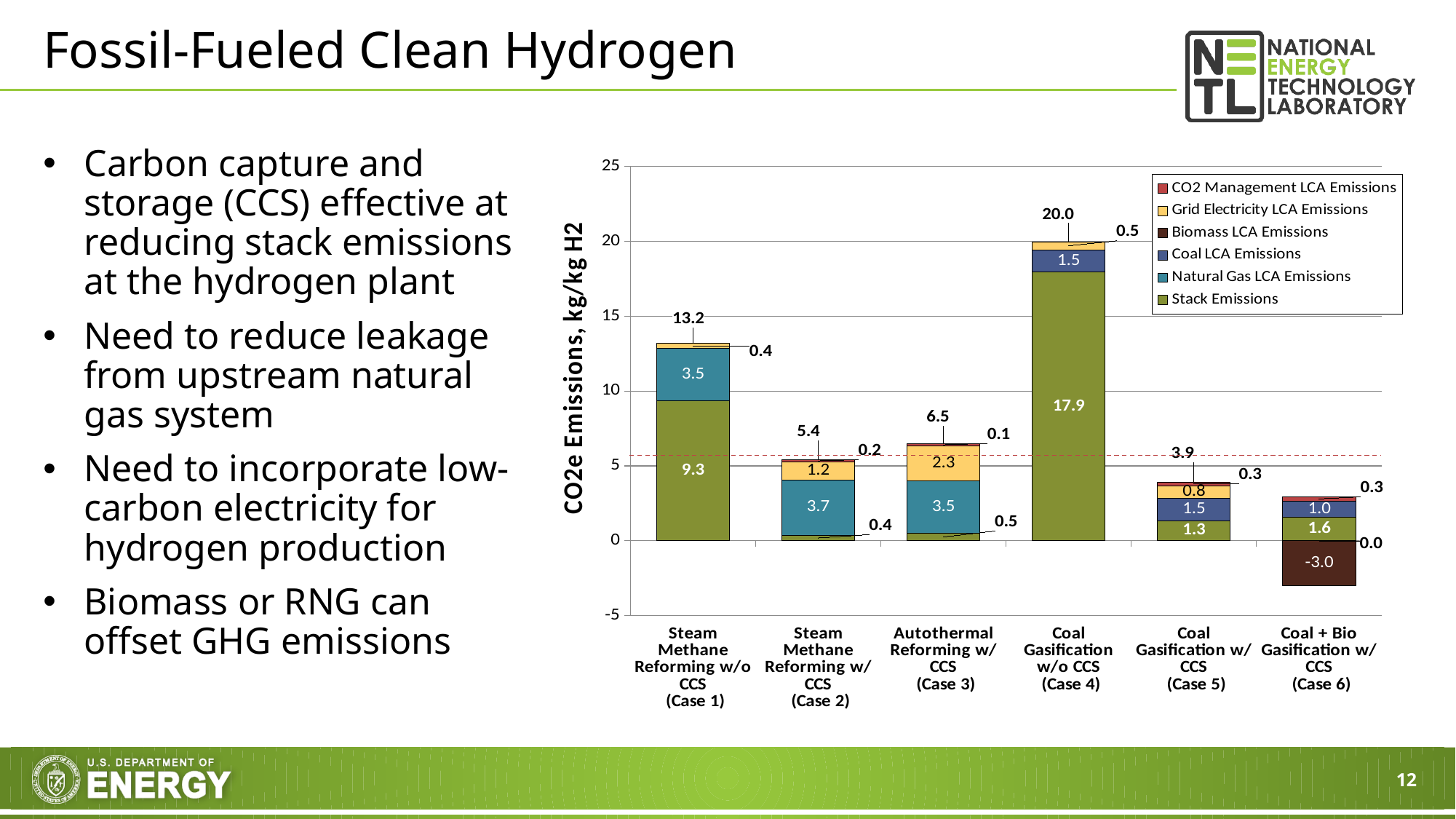
What is the label on the y axis of the chart? CO2e Emissions, kg/kg H2 How many cases (categories) are plotted along the x axis? 6 What kind of chart is shown on the slide? Stacked bar chart Is the total for Coal Gasification w/ CCS (Case 5) greater or less than 5? less What is the Biomass LCA Emissions value for Coal + Bio Gasification w/ CCS (Case 6)? -3.0 How many series does the legend list? 6 Which case has the highest total CO2e emissions? Coal Gasification w/o CCS (Case 4) What is the total CO2e emissions value for Steam Methane Reforming w/o CCS (Case 1)? 13.2 What is the difference between the total emissions of Case 4 (20.0) and Case 1 (13.2)? 6.8 What is the Natural Gas LCA Emissions value for Steam Methane Reforming w/ CCS (Case 2)? 3.7 What is the Stack Emissions value for Coal Gasification w/o CCS (Case 4)? 17.9 Which has the larger total CO2e emissions: Autothermal Reforming w/ CCS (Case 3) or Steam Methane Reforming w/ CCS (Case 2)? Autothermal Reforming w/ CCS (Case 3)